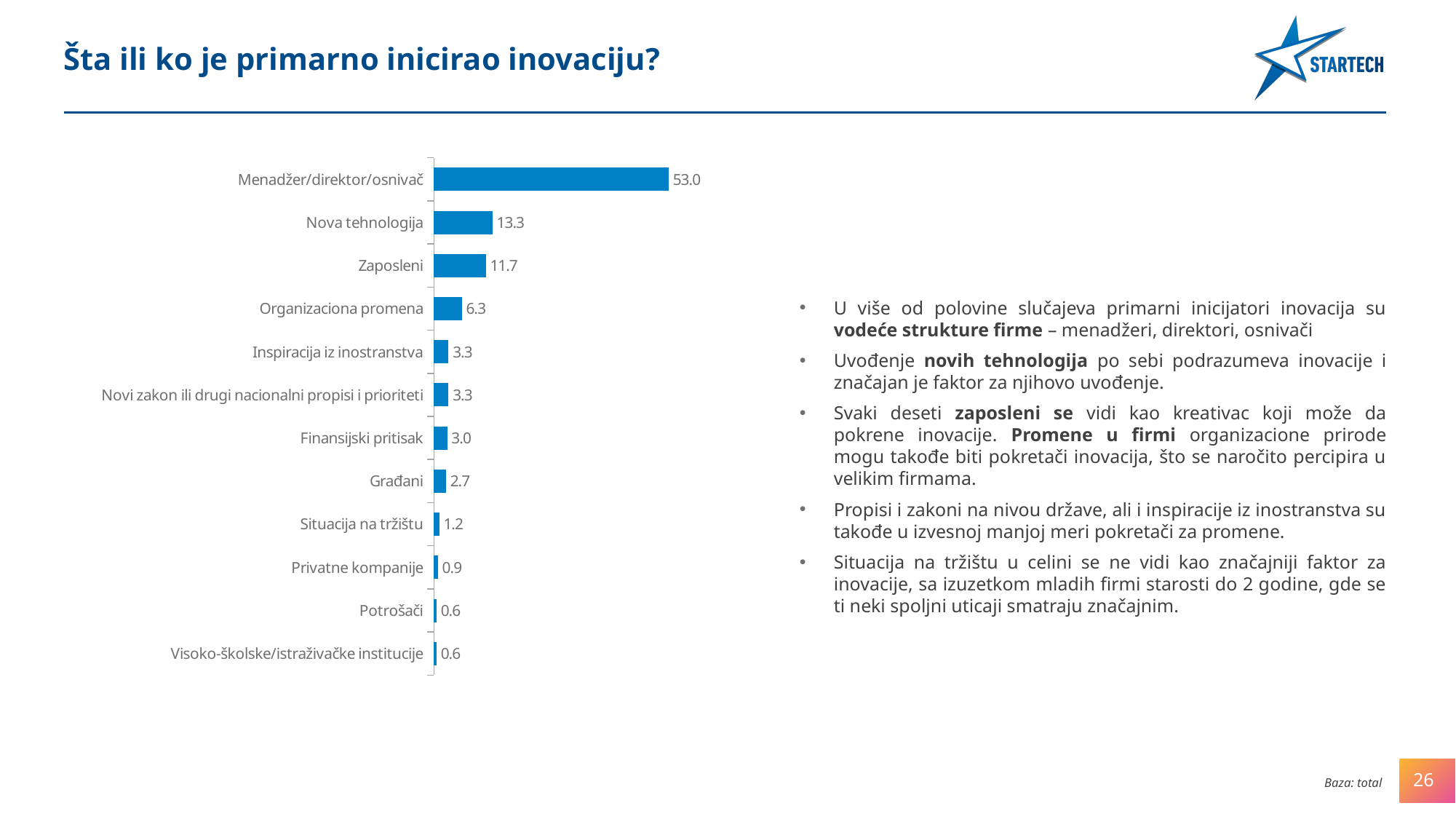
What is the title of the slide containing the chart? Šta ili ko je primarno inicirao inovaciju? How many categories are shown in the chart? 12 What is the difference between the values for Nova tehnologija and Zaposleni? 1.6 What is the value for Privatne kompanije? 0.9 What is the value for Menadžer/direktor/osnivač? 53.0 What is the value for Organizaciona promena? 6.3 What kind of chart is shown on the slide? Bar chart Which category has the highest value? Menadžer/direktor/osnivač What is the value for Nova tehnologija? 13.3 What is the difference between the values for Menadžer/direktor/osnivač and Nova tehnologija? 39.7 Which is larger, the value for Finansijski pritisak or the value for Situacija na tržištu? Finansijski pritisak What is the value for Građani? 2.7